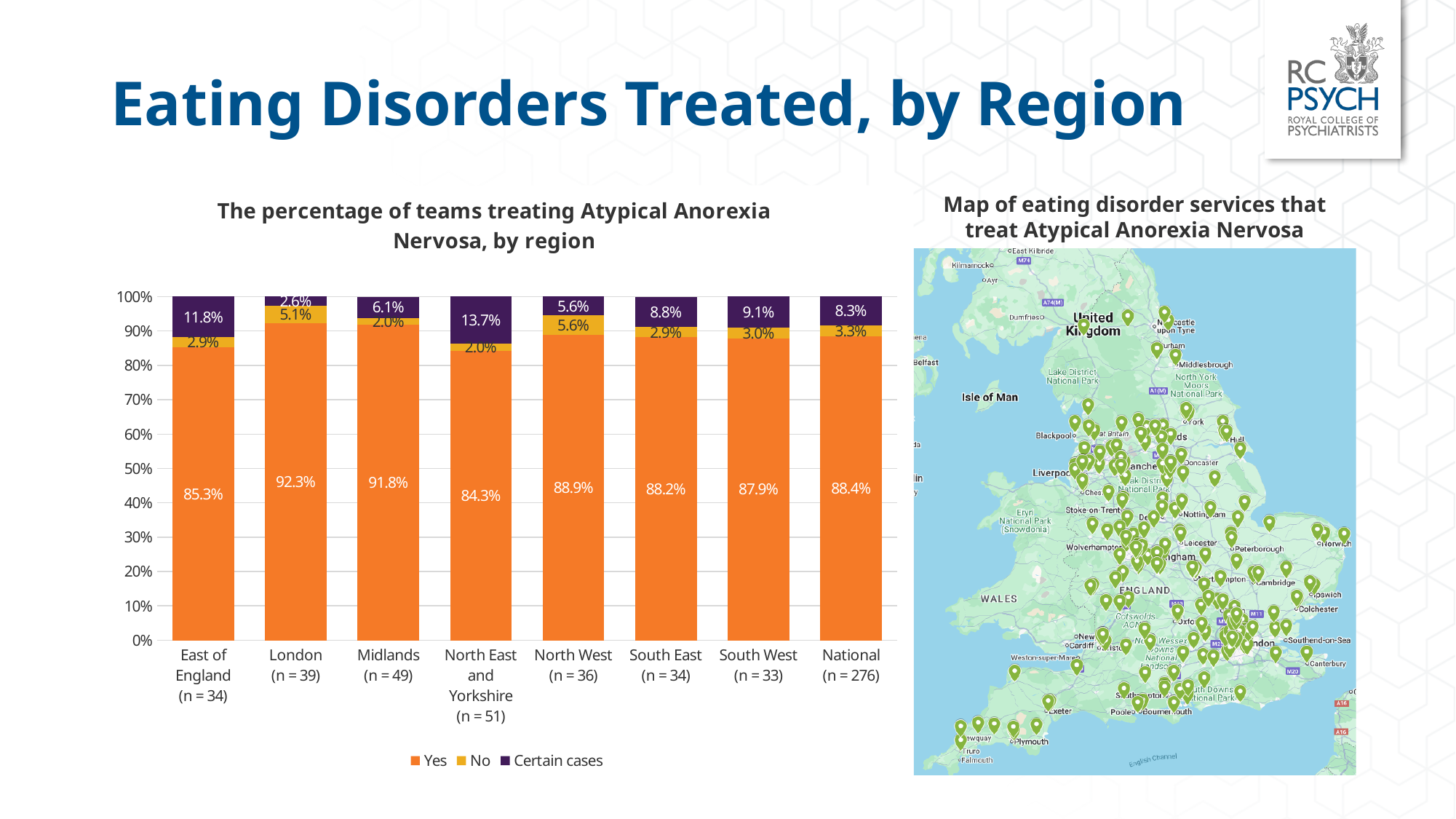
What is the sample size (n) shown for the Midlands? 49 What is the "No" percentage for the National bar? 3.3% Which region has the lowest "Yes" percentage? North East and Yorkshire Which region has the highest "Yes" percentage? London What percentage of teams in London answered "Yes" to treating Atypical Anorexia Nervosa? 92.3% How many series does the legend list? 3 Which has a larger "Certain cases" percentage, East of England or South East? East of England What kind of chart is used to show the percentage of teams treating Atypical Anorexia Nervosa by region? Stacked bar chart How many region categories (including National) are shown on the x axis? 8 What are the three legend entries of the bar chart? Yes, No, Certain cases What is the "Certain cases" percentage for North East and Yorkshire? 13.7% What is the difference in percentage points between the "Yes" value for London and the "Yes" value for North East and Yorkshire? 8.0 percentage points